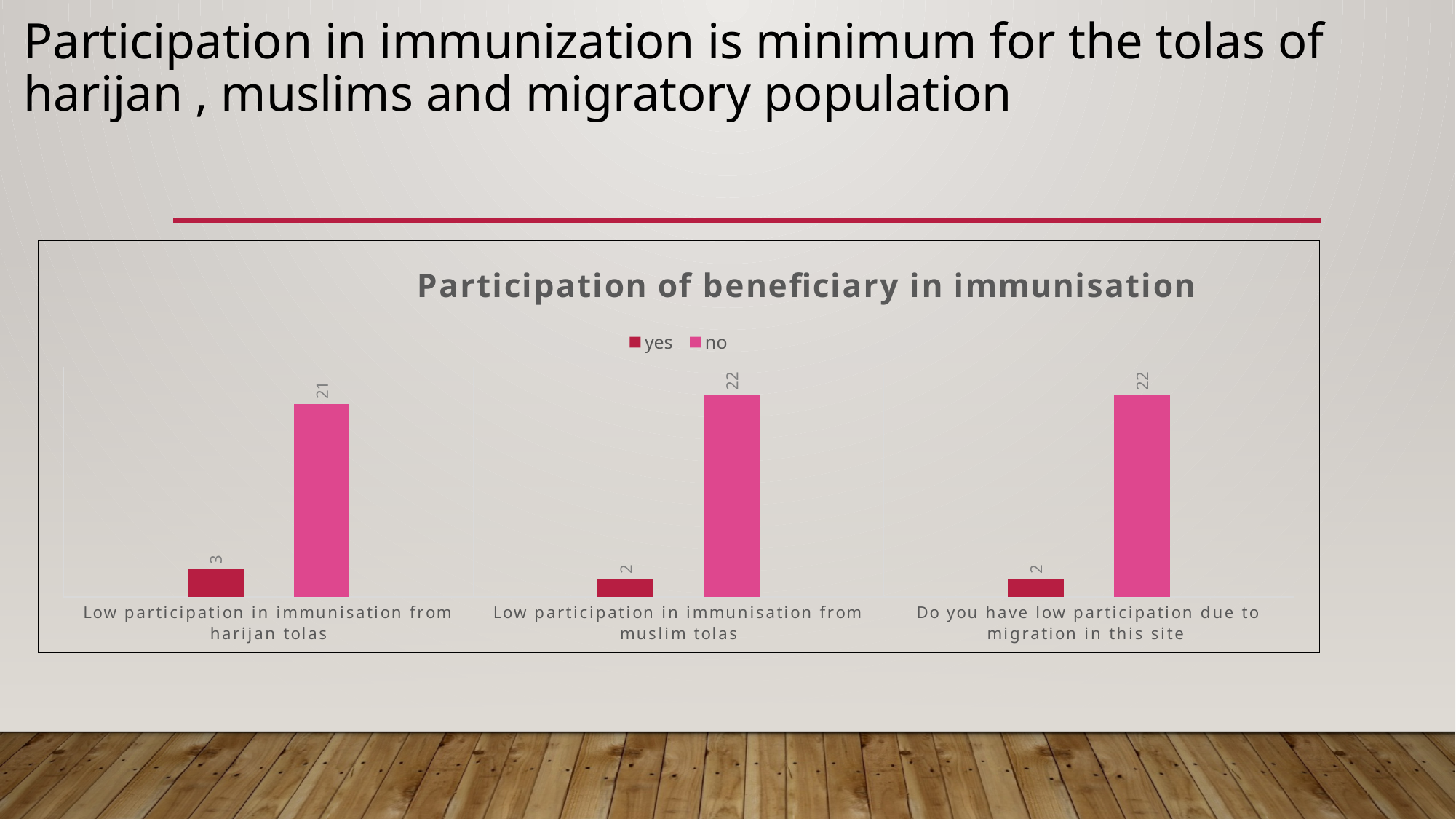
How many categories are shown on the x axis? 3 For 'Low participation in immunisation from harijan tolas', which is larger, the 'yes' value or the 'no' value? no What is the 'no' value for 'Do you have low participation due to migration in this site'? 22 What is the 'yes' value for 'Low participation in immunisation from muslim tolas'? 2 Which category has the highest 'yes' value? Low participation in immunisation from harijan tolas What is the 'no' value for 'Low participation in immunisation from harijan tolas'? 21 What is the difference between the 'no' and 'yes' values for 'Low participation in immunisation from muslim tolas'? 20 What is the 'yes' value for 'Low participation in immunisation from harijan tolas'? 3 How many series does the legend list? 2 What is the title of the chart? Participation of beneficiary in immunisation Which category has the lowest 'no' value? Low participation in immunisation from harijan tolas What kind of chart is shown on the slide? Bar chart